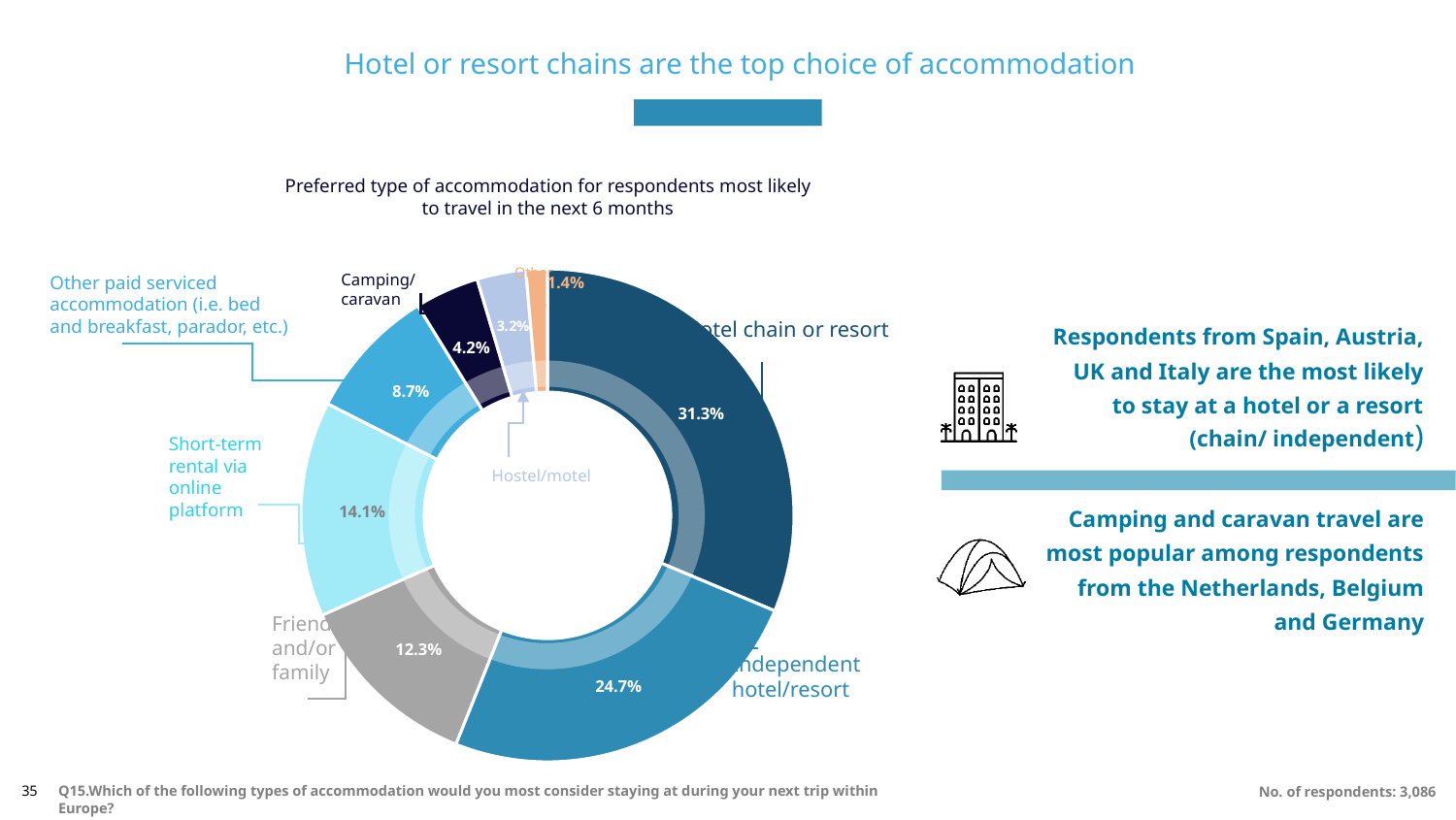
Which is larger: the share for short-term rental via online platform or the share for friends and/or family? Short-term rental via online platform Which labelled accommodation type has the smallest share in the chart? Other (1.4%) Which type of accommodation has the largest share in the chart? Hotel chain or resort What percentage of respondents prefer an independent hotel/resort? 24.7% How many accommodation categories are shown in the chart? 8 What type of chart is shown on the slide? Pie (donut) chart What percentage of respondents prefer a hotel chain or resort? 31.3% What percentage of respondents prefer a hostel/motel? 3.2% What percentage of respondents prefer other paid serviced accommodation (i.e. bed and breakfast, parador, etc.)? 8.7% What is the difference in percentage points between hotel chain or resort and independent hotel/resort? 6.6 percentage points What share of respondents prefer short-term rental via online platform? 14.1% What percentage of respondents prefer camping/caravan? 4.2%